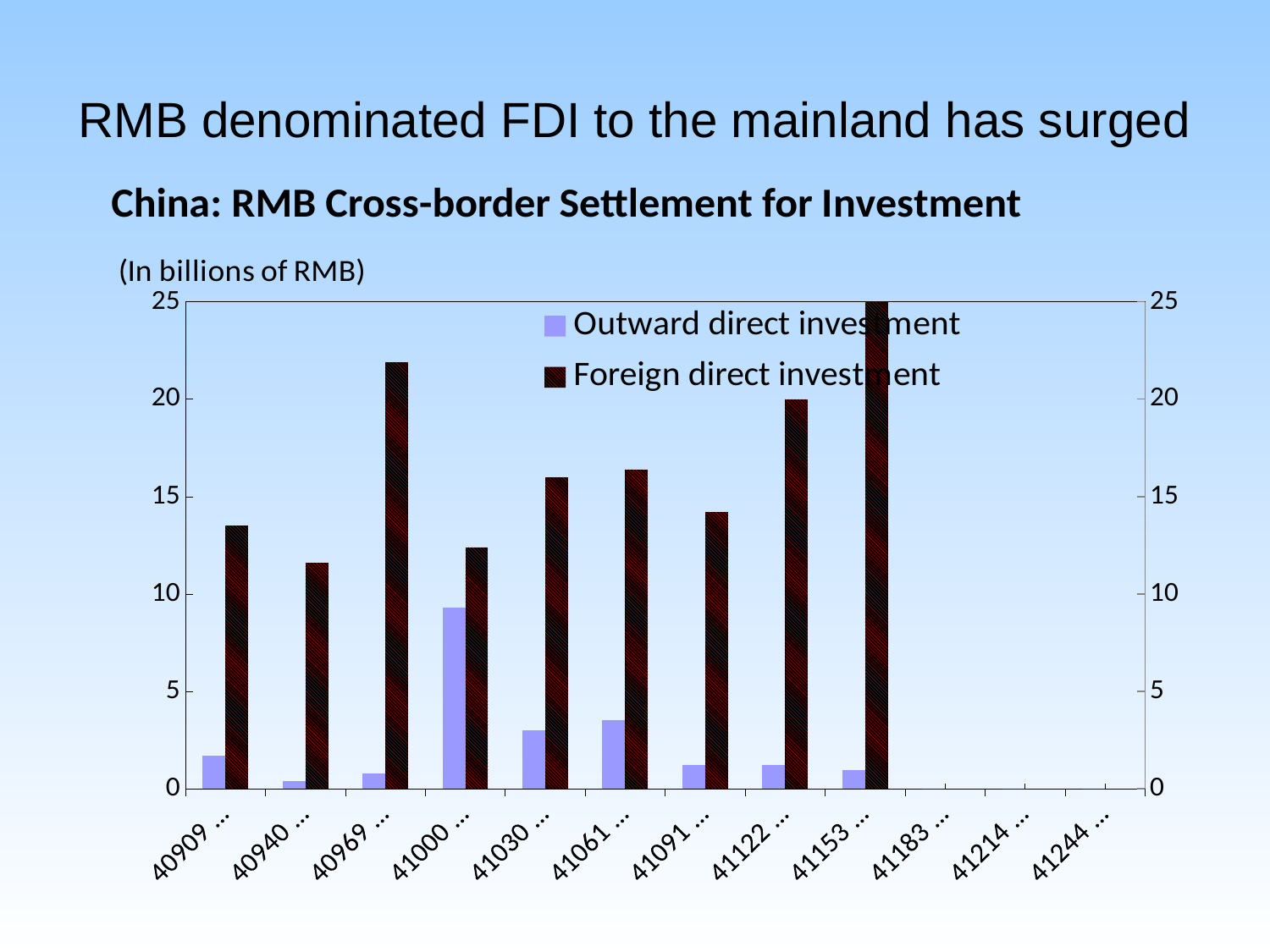
How many category labels are shown along the x axis? 12 What kind of chart is shown on the slide? bar chart For which category is the Foreign direct investment bar the highest? 41153 … Which is larger: the Outward direct investment value for 41000 … or for 41030 …? 41000 … Is the Outward direct investment value for 41000 … greater or less than 5? greater For which category is the Outward direct investment bar the highest? 41000 … Which is larger: the Foreign direct investment value for 40969 … or for 41061 …? 40969 … How many series does the legend list? 2 What are the two series named in the legend? Outward direct investment; Foreign direct investment What is the title of the chart? China: RMB Cross-border Settlement for Investment Is the Foreign direct investment value for 40969 … greater or less than 20? greater Is the Foreign direct investment value for 40940 … greater or less than 15? less